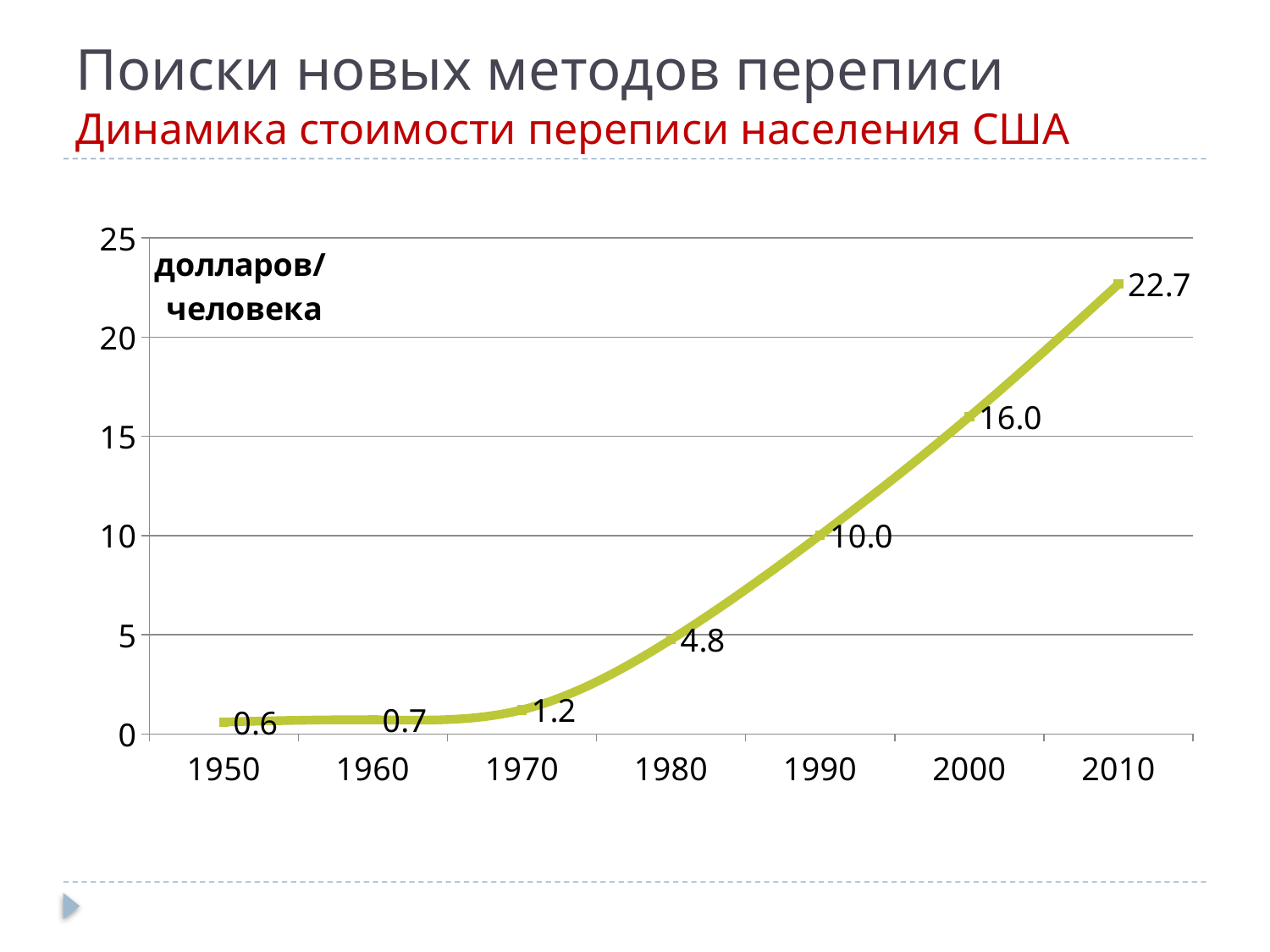
What is the value for 1980? 4.8 What is the difference between the values for 1990 and 1980? 5.2 Is the value for 2000 greater or less than 15? greater What is the value for 2010? 22.7 Which year has the highest value? 2010 Which year has the lowest value? 1950 Do the values rise or fall from 1950 to 2010? rise How many data points are plotted on the chart? 7 What is the value for 1950? 0.6 What kind of chart is shown on the slide? line chart What is the difference between the values for 2010 and 2000? 6.7 Which is larger, the value for 1970 or the value for 1990? 1990